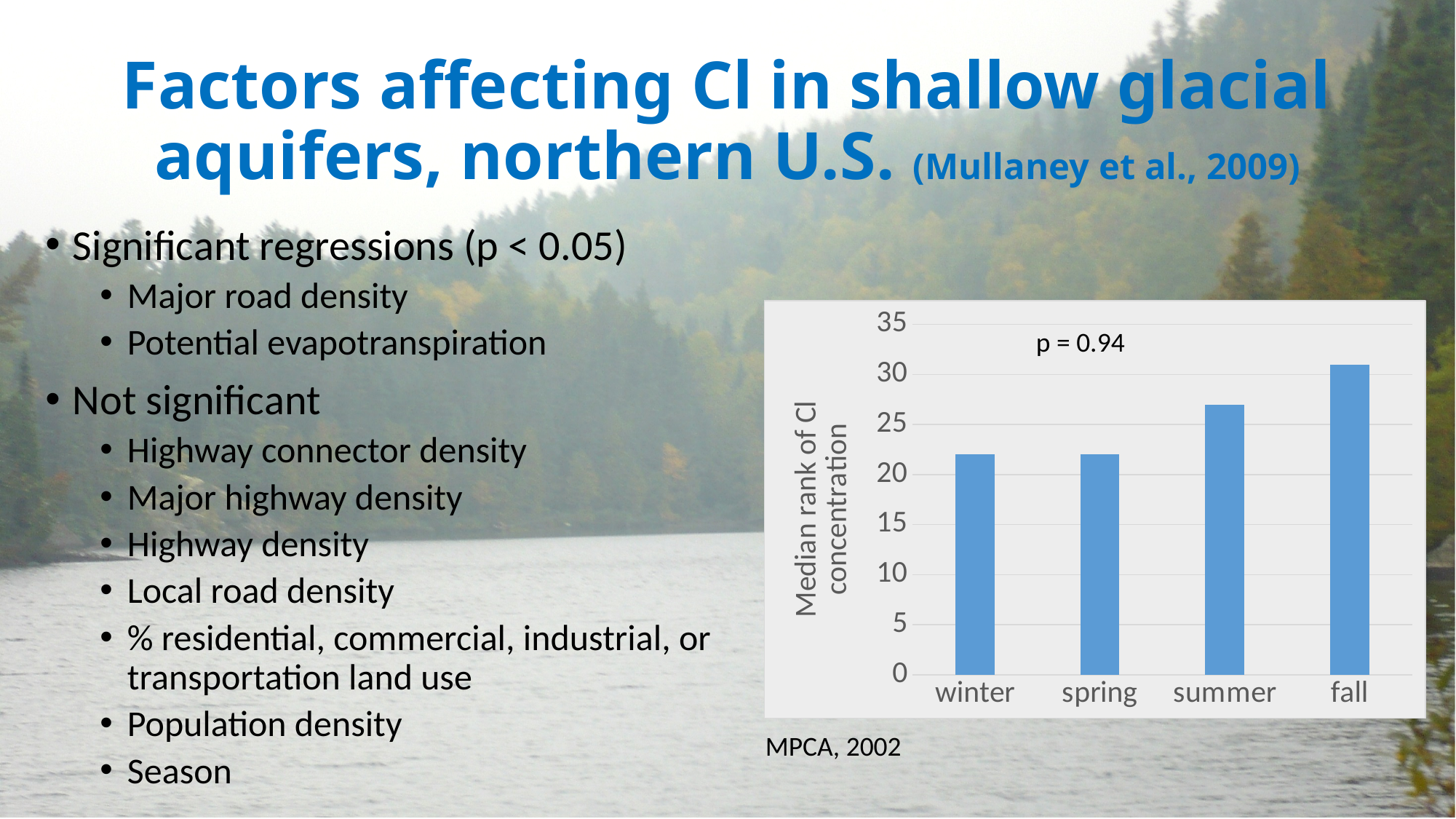
What p value is annotated on the chart? p = 0.94 Is the value for winter greater or less than 20? greater What is the label on the y axis of the chart? Median rank of Cl concentration Is the value for summer greater or less than 25? greater Which season has the highest median rank of Cl concentration? fall Do the values generally rise or fall from winter to fall along the x axis? rise Which is larger, the value for fall or the value for winter? fall Is the value for spring greater or less than 25? less Which is larger, the value for summer or the value for spring? summer How many seasons are plotted on the x axis of the chart? 4 What kind of chart is shown on the slide? bar chart